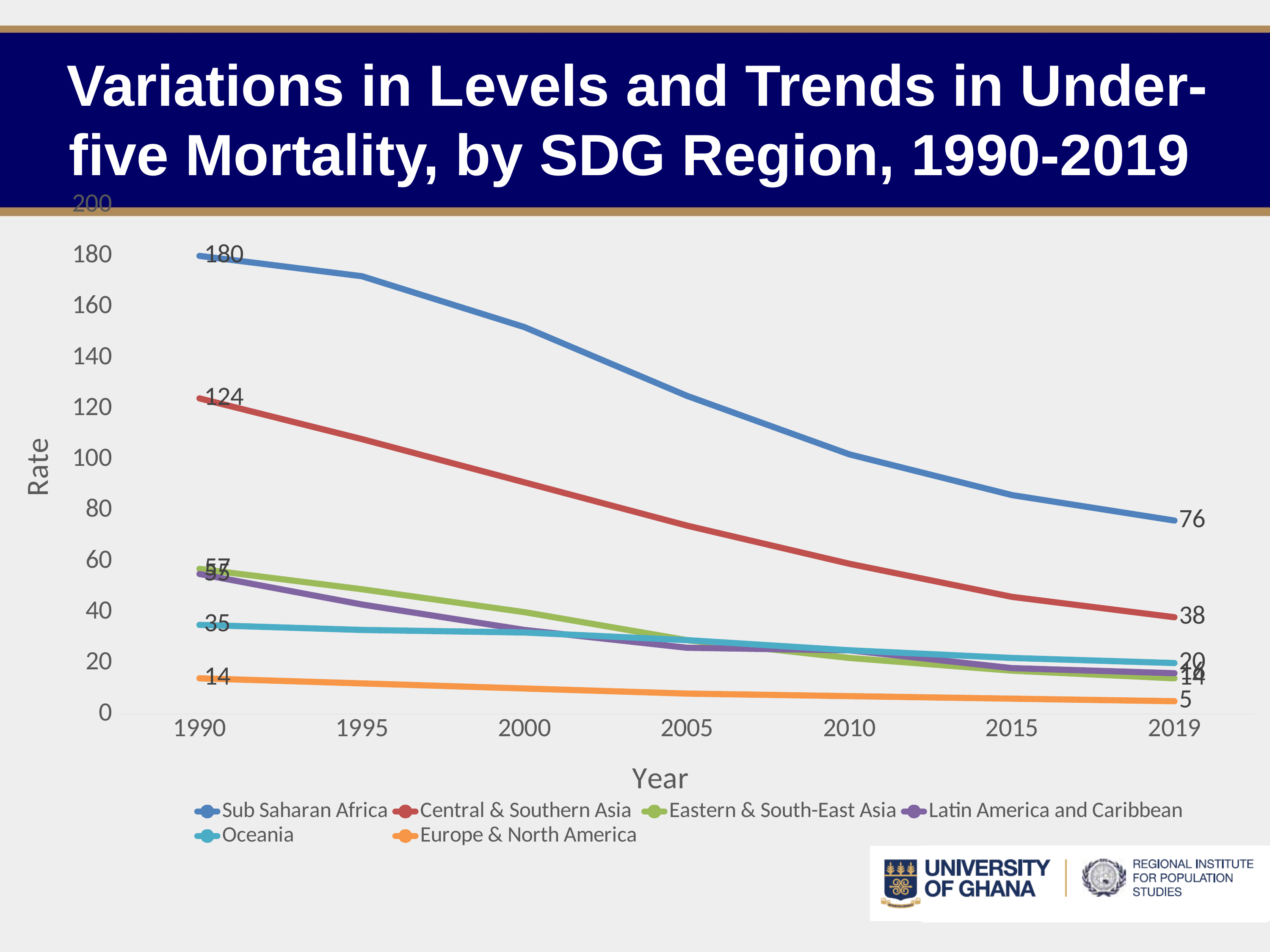
What is the value for Europe & North America in 2019? 5 How many series does the legend list? 6 What is the value for Central & Southern Asia in 2019? 38 Which region had the lowest under-five mortality rate in 2019? Europe & North America How many years are marked on the x axis? 7 Which region had the highest under-five mortality rate in 1990? Sub Saharan Africa What is the value for Central & Southern Asia in 1990? 124 What kind of chart is shown on the slide? line chart What is the under-five mortality rate for Sub Saharan Africa in 2019? 76 By how much did the rate for Sub Saharan Africa fall between 1990 and 2019? 104 Is the value for Central & Southern Asia in 2005 greater or less than 100? less What is the under-five mortality rate for Sub Saharan Africa in 1990? 180